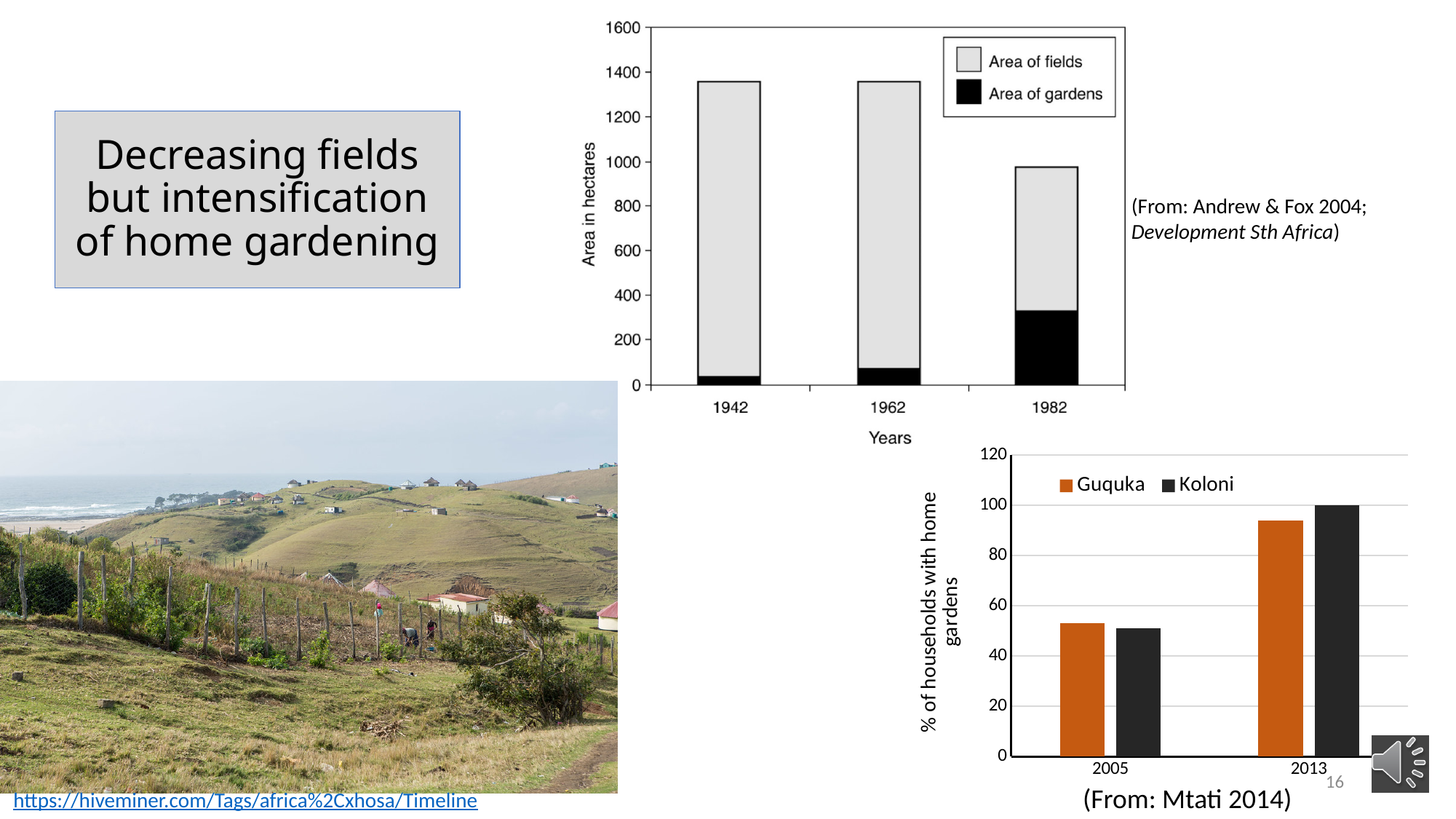
In the top chart (Area in hectares), does the area of gardens rise or fall from 1942 to 1982? rise In the bottom chart (% of households with home gardens), which colour represents Guquka? orange In the top chart (Area in hectares), how many series does the legend list? 2 In the top chart (Area in hectares), is the total area in 1942 greater or less than 1200? greater In the bottom chart (% of households with home gardens), is the value for Koloni in 2013 greater or less than 80? greater What type of chart is the top chart showing area in hectares? stacked bar chart In the top chart (Area in hectares), which year has the largest area of gardens? 1982 In the bottom chart (% of households with home gardens), how many series does the legend list? 2 In the top chart (Area in hectares), is the area of gardens in 1982 greater or less than 200? greater In the top chart (Area in hectares), how many years are shown on the x axis? 3 In the top chart (Area in hectares), which year has the lowest total area? 1982 In the bottom chart (% of households with home gardens), which is larger for Guquka: 2005 or 2013? 2013